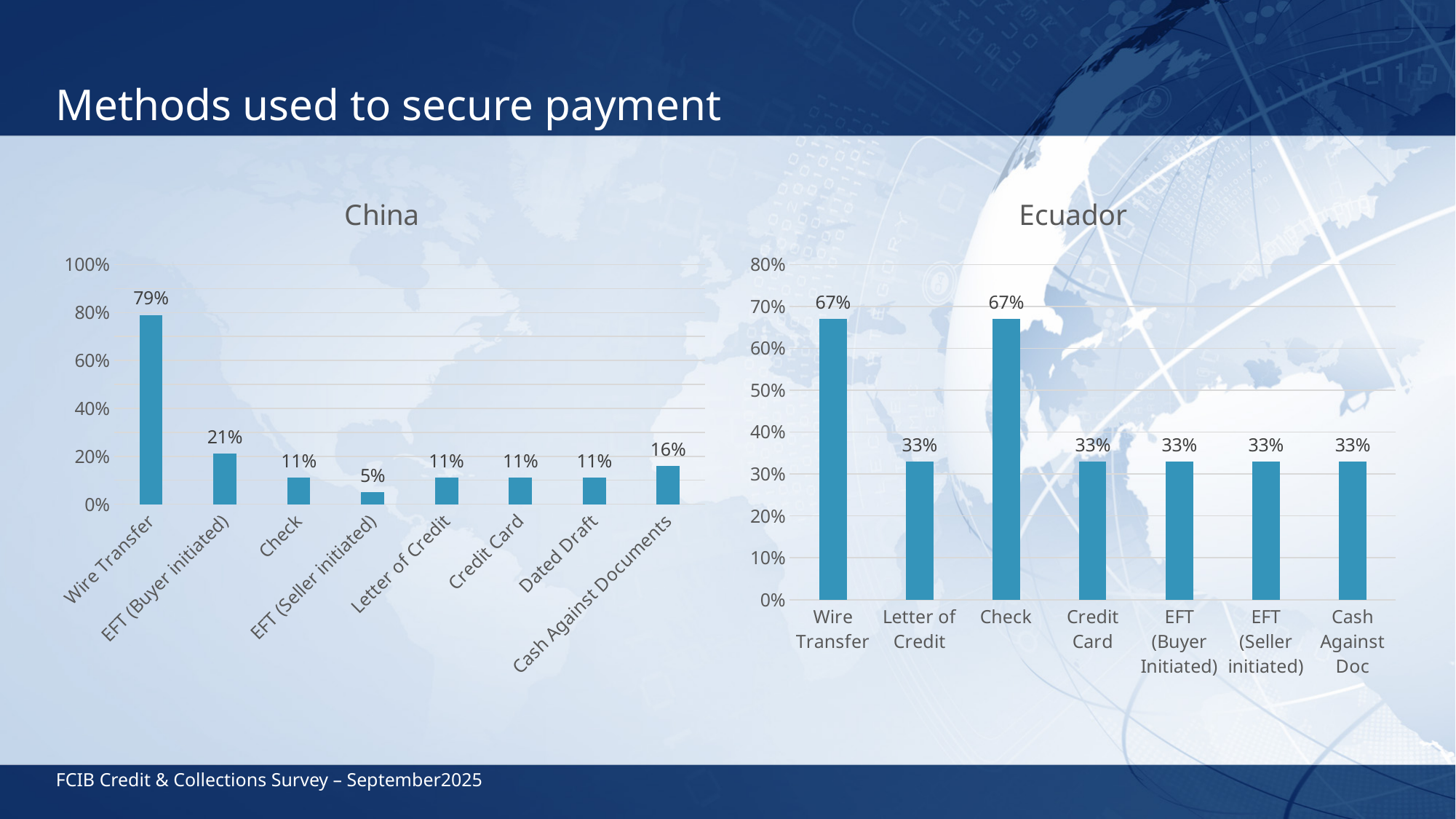
In the China chart, what is the value for Wire Transfer? 79% In the Ecuador chart, what is the value for Check? 67% In the China chart, which method has the lowest value? EFT (Seller initiated) In the Ecuador chart, which is larger, Wire Transfer or Credit Card? Wire Transfer In the China chart, what is the value for EFT (Seller initiated)? 5% In the China chart, which method has the highest value? Wire Transfer In the China chart, what is the difference between Wire Transfer and EFT (Buyer initiated)? 58% What type of chart is the Ecuador chart? Bar chart In the Ecuador chart, how many payment methods are shown? 7 In the Ecuador chart, what is the value for Letter of Credit? 33% In the Ecuador chart, what is the difference between Check and Credit Card? 34% In the China chart, how many payment methods are shown? 8